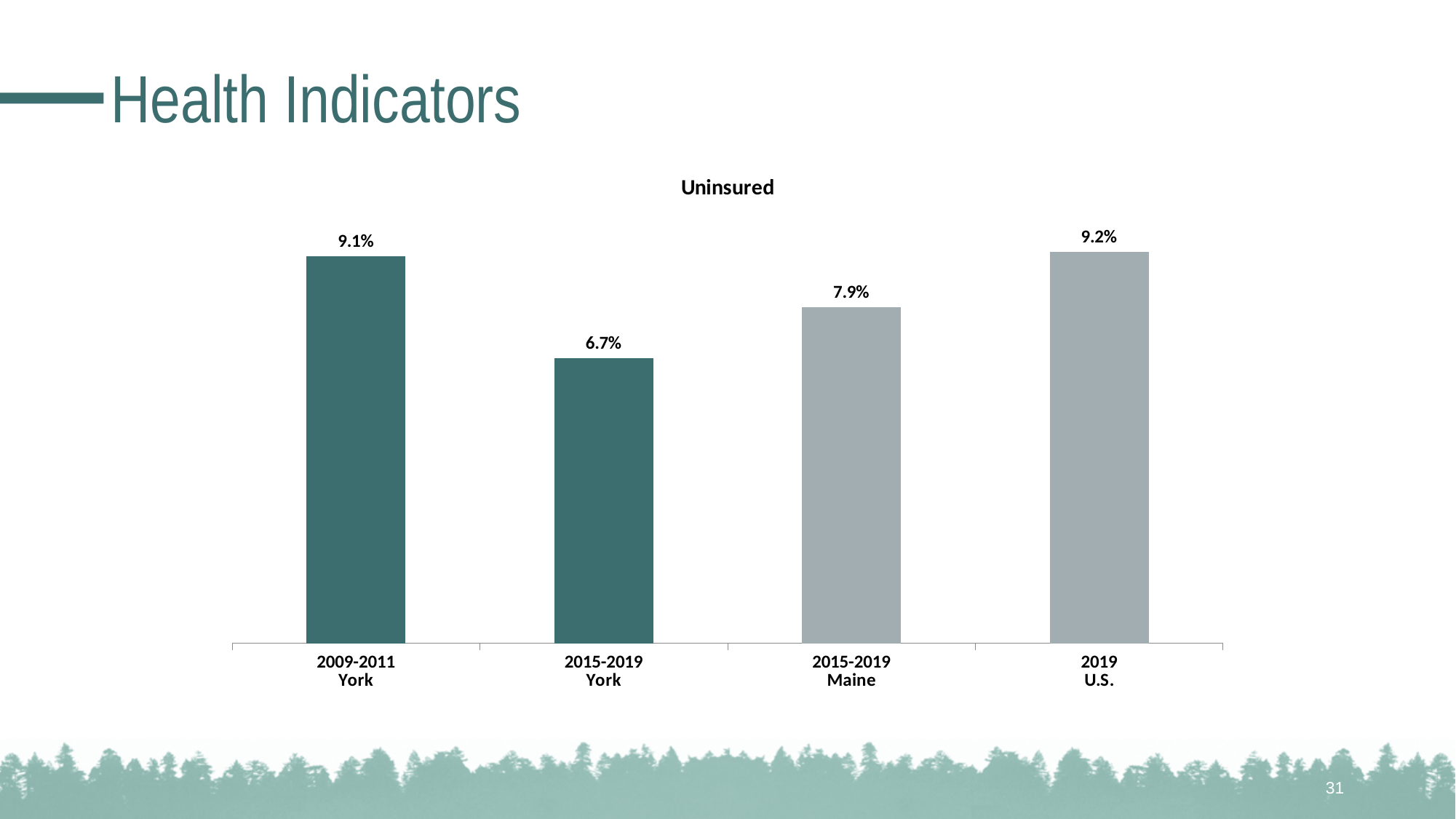
What type of chart is shown on the slide? Bar chart Which category has the lowest uninsured rate? 2015-2019 York What is the uninsured rate for York in 2015-2019? 6.7% What is the title of the chart? Uninsured What is the difference between the York uninsured rate in 2009-2011 and in 2015-2019? 2.4% Which is larger, the uninsured rate for Maine in 2015-2019 or for York in 2015-2019? Maine 2015-2019 What is the difference between the Maine 2015-2019 uninsured rate and the York 2015-2019 uninsured rate? 1.2% What is the uninsured rate for Maine in 2015-2019? 7.9% How many bars are shown in the chart? 4 What is the uninsured rate for York in 2009-2011? 9.1% What is the uninsured rate for the U.S. in 2019? 9.2% Which category has the highest uninsured rate? 2019 U.S.